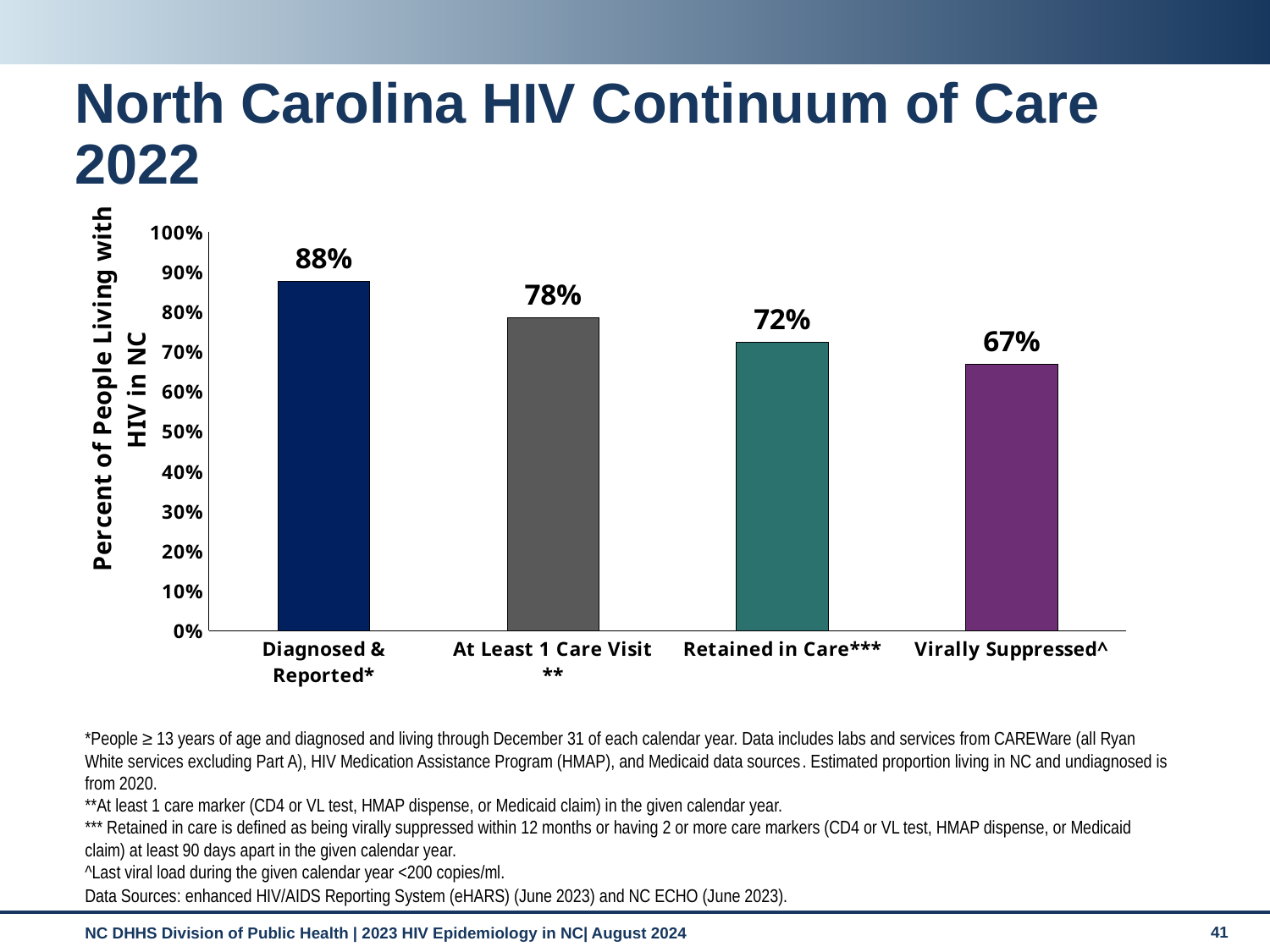
Which category has the lowest value? Virally Suppressed^ How many categories are shown on the x axis? 4 What percentage is shown for Diagnosed & Reported*? 88% Do the values rise or fall from left to right along the x axis? Fall What is the difference between the Diagnosed & Reported* value and the Virally Suppressed^ value? 21% Which is larger, the value for Retained in Care*** or the value for Virally Suppressed^? Retained in Care*** Which category has the highest value? Diagnosed & Reported* What percentage is shown for Virally Suppressed^? 67% What kind of chart is shown on the slide? Bar chart What is the difference between the At Least 1 Care Visit** value and the Retained in Care*** value? 6% What percentage is shown for At Least 1 Care Visit**? 78% What percentage is shown for Retained in Care***? 72%